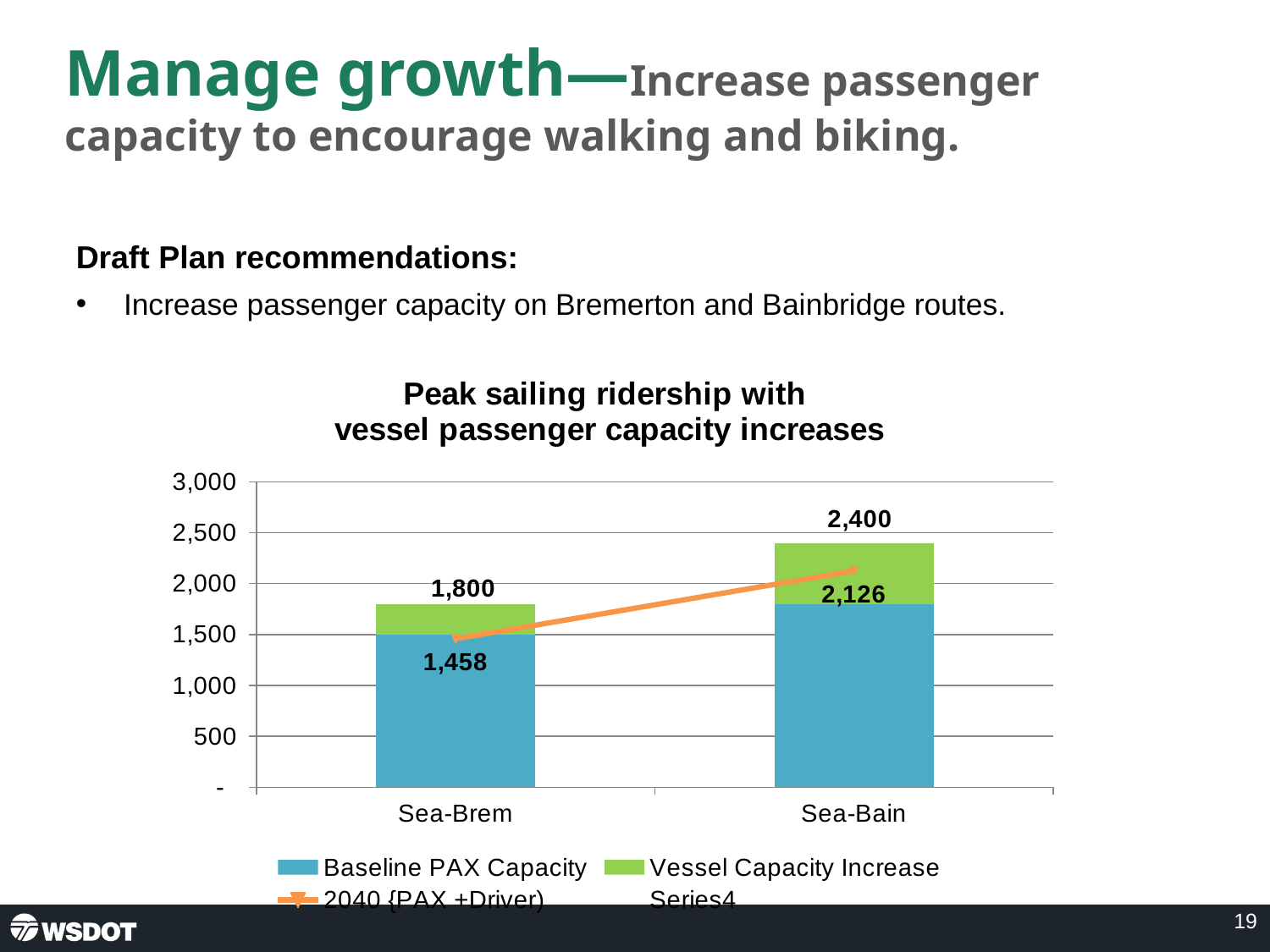
What kind of chart is shown on the slide? combination bar and line chart (stacked bars with a line) What is the title of the chart? Peak sailing ridership with vessel passenger capacity increases What is the 2040 (PAX +Driver) value for Sea-Brem? 1,458 What is the difference between the values labelled at the top of the Sea-Bain and Sea-Brem bars? 600 Does the 2040 (PAX +Driver) line rise or fall from Sea-Brem to Sea-Bain? rises What value is labelled at the top of the Sea-Brem stacked bar? 1,800 What is the 2040 (PAX +Driver) value for Sea-Bain? 2,126 How many series does the chart legend list? 4 What value is labelled at the top of the Sea-Bain stacked bar? 2,400 Is the Baseline PAX Capacity for Sea-Bain greater or less than 1,500? greater Which route has the higher 2040 (PAX +Driver) value, Sea-Brem or Sea-Bain? Sea-Bain How many routes (categories) are shown on the x axis of the chart? 2